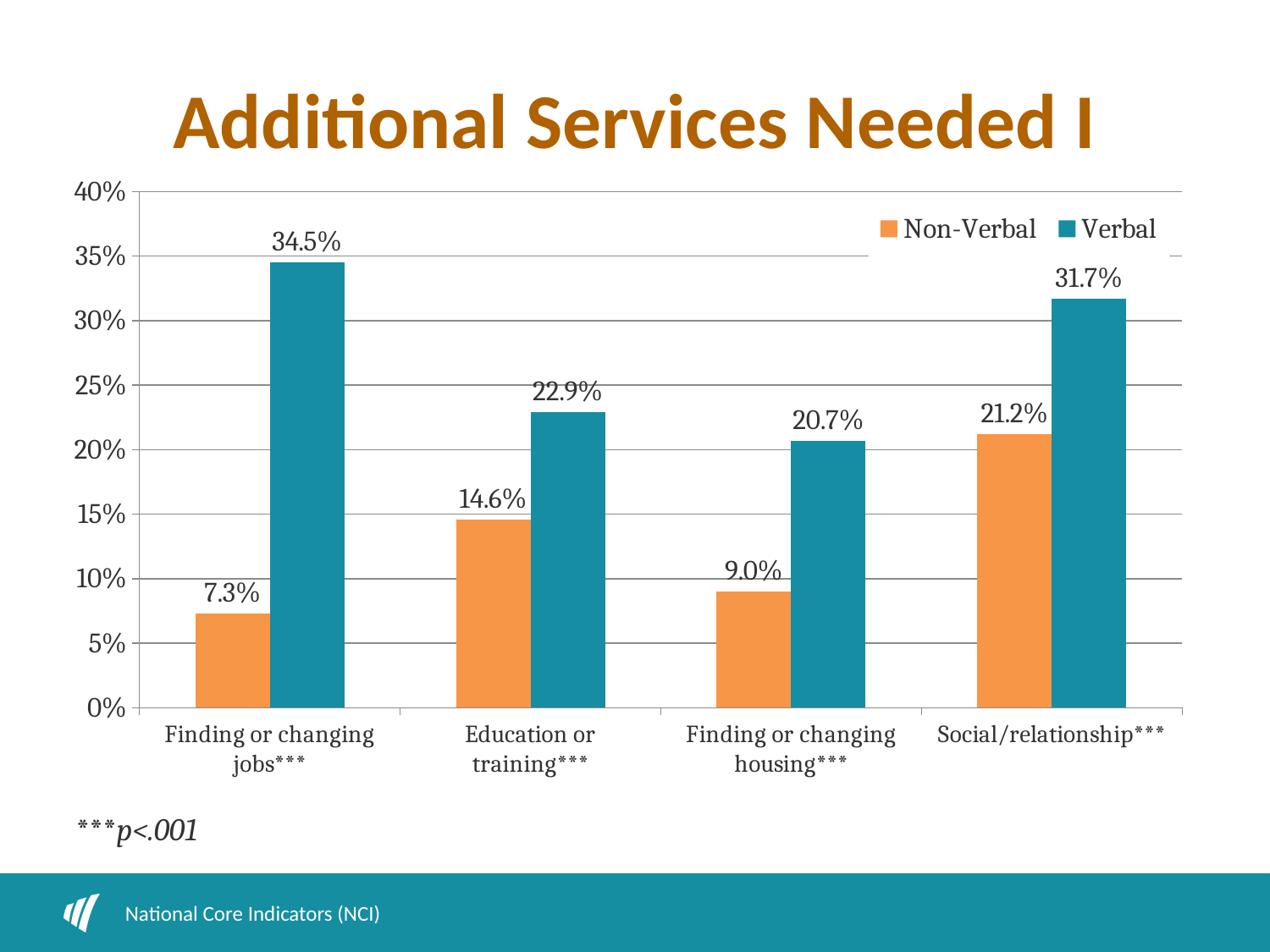
How many categories are shown on the x axis? 4 Which category has the highest Non-Verbal value? Social/relationship*** Which category has the lowest Verbal value? Finding or changing housing*** Which is larger: the Non-Verbal value for Social/relationship*** or the Verbal value for Finding or changing housing***? Non-Verbal value for Social/relationship*** How many series does the legend list? 2 What is the Non-Verbal value for Finding or changing housing***? 9.0% What kind of chart is shown on the slide? Bar chart What is the Verbal value for Finding or changing jobs***? 34.5% What is the difference between the Verbal and Non-Verbal values for Finding or changing jobs***? 27.2% What is the Non-Verbal value for Education or training***? 14.6% What is the title of the chart? Additional Services Needed I What is the Verbal value for Social/relationship***? 31.7%